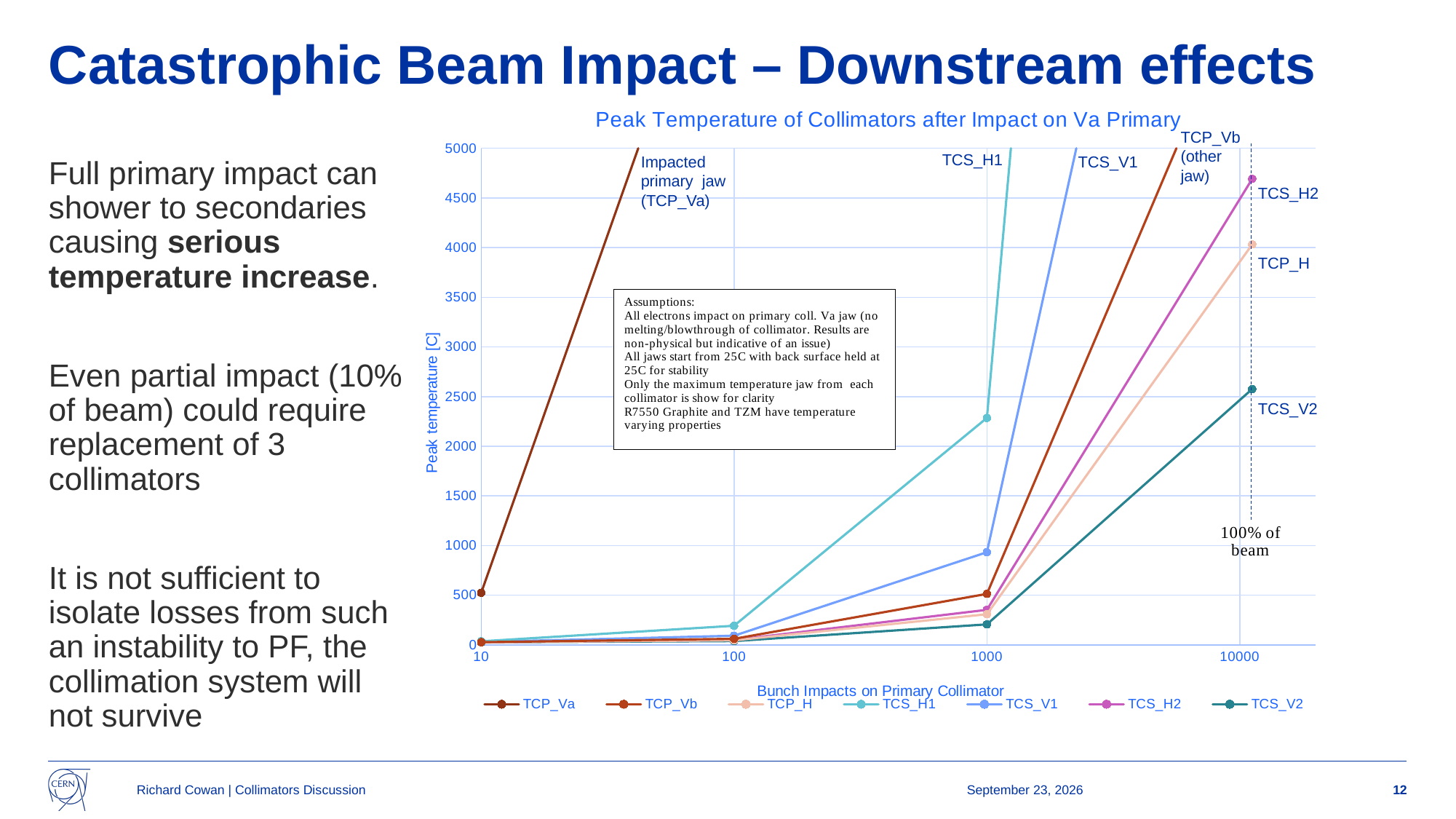
Is the peak temperature of TCS_V2 at 1000 bunch impacts greater or less than 500? less At 1000 bunch impacts, which has the higher peak temperature, TCS_H1 or TCS_V1? TCS_H1 Is the peak temperature of TCS_H2 at 100% of beam greater or less than 4000? greater Is the peak temperature of TCS_V1 at 1000 bunch impacts greater or less than 1000? less What is the title of the chart? Peak Temperature of Collimators after Impact on Va Primary What kind of chart is shown on the slide? line chart Do the peak temperatures rise or fall as the number of bunch impacts increases? rise How many series does the legend of the chart list? 7 What is the label of the y axis of the chart? Peak temperature [C] At 100% of beam, which series has the lowest peak temperature? TCS_V2